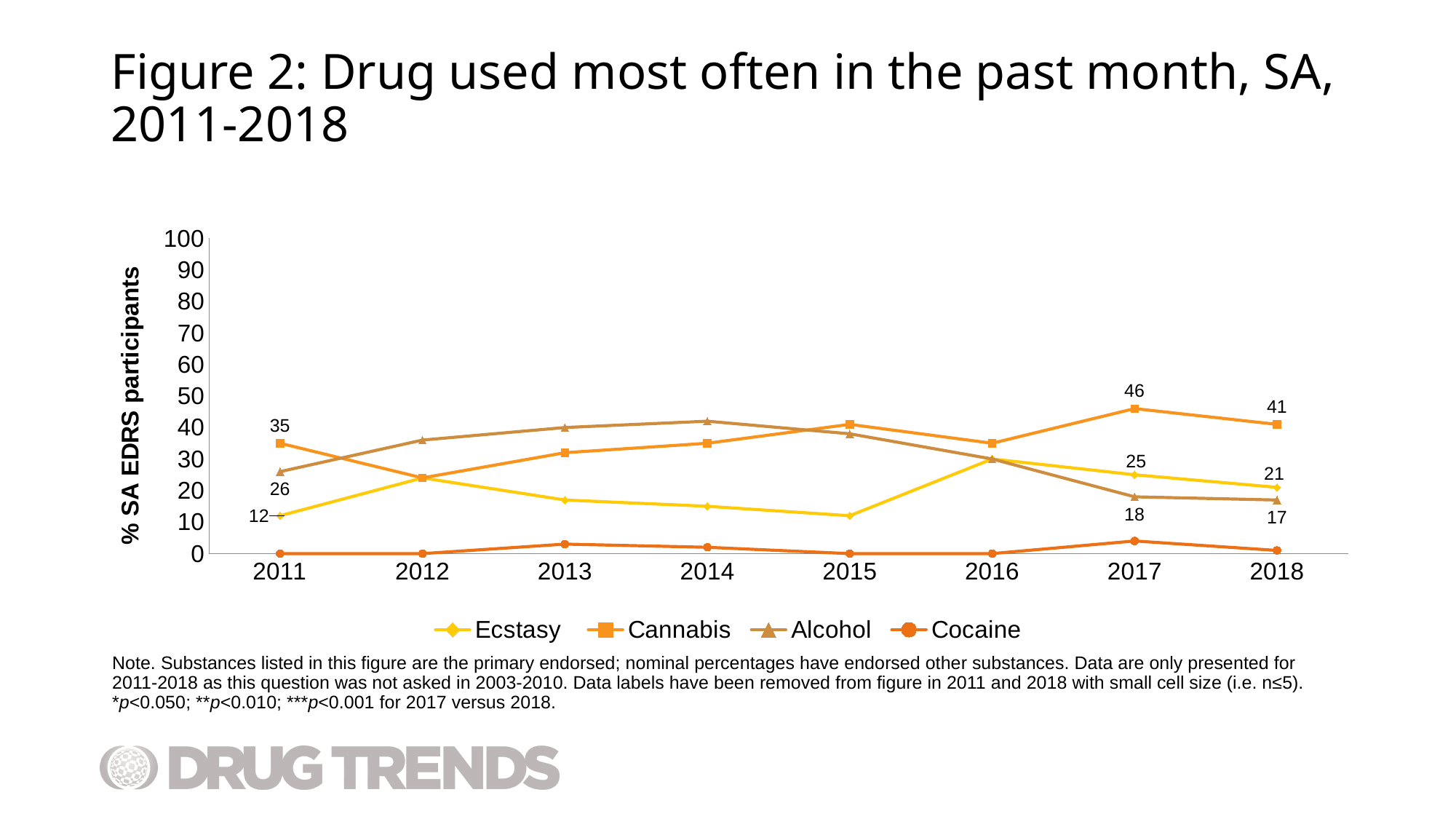
How many series does the legend list? 4 What was the value for Alcohol in 2011? 26 What is the difference between the Ecstasy values in 2017 and 2011? 13 What was the value for Ecstasy in 2018? 21 Which series had the lowest value in 2017? Cocaine What kind of chart is shown on the slide? line chart Is the value for Ecstasy in 2015 greater or less than 20? less How many years are shown on the x axis? 8 By how much did the Cannabis value fall from 2017 to 2018? 5 In 2011, which was higher: Cannabis or Alcohol? Cannabis What percentage of SA EDRS participants reported Cannabis as the drug used most often in 2017? 46 Which series had the highest value in 2018? Cannabis